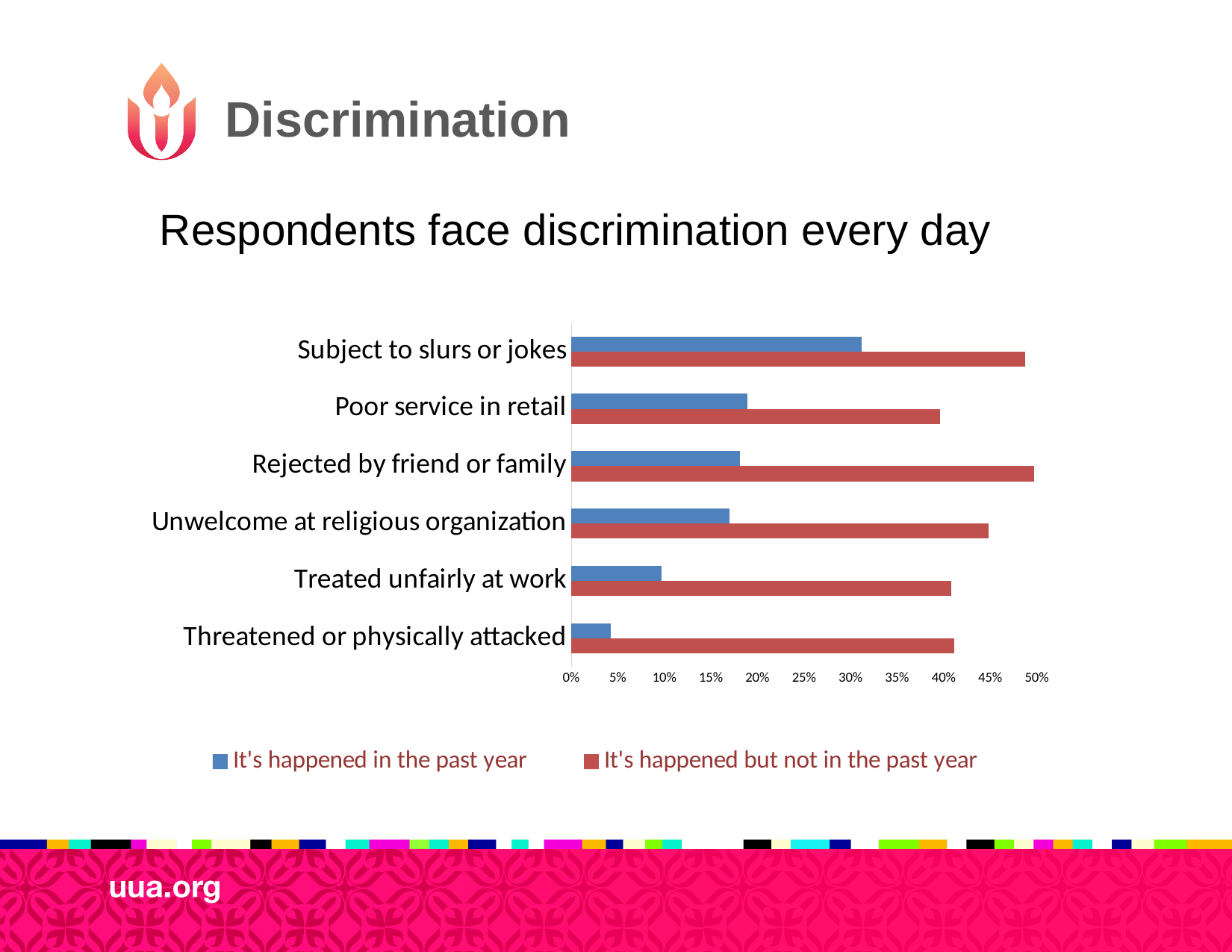
How many categories of discrimination are listed on the chart? 6 Which has the larger "It's happened but not in the past year" value: Rejected by friend or family or Poor service in retail? Rejected by friend or family How many series does the chart's legend list? 2 Is the "It's happened in the past year" value for Threatened or physically attacked greater or less than 5%? less Is the "It's happened in the past year" value for Subject to slurs or jokes greater or less than 25%? greater Which series is shown in blue in the chart's legend? It's happened in the past year Is the "It's happened in the past year" value for Treated unfairly at work greater or less than 15%? less Which category has the highest value for "It's happened in the past year"? Subject to slurs or jokes Which category has the lowest value for "It's happened in the past year"? Threatened or physically attacked For Threatened or physically attacked, which series has the larger value: "It's happened in the past year" or "It's happened but not in the past year"? It's happened but not in the past year What kind of chart is shown on the slide? Bar chart